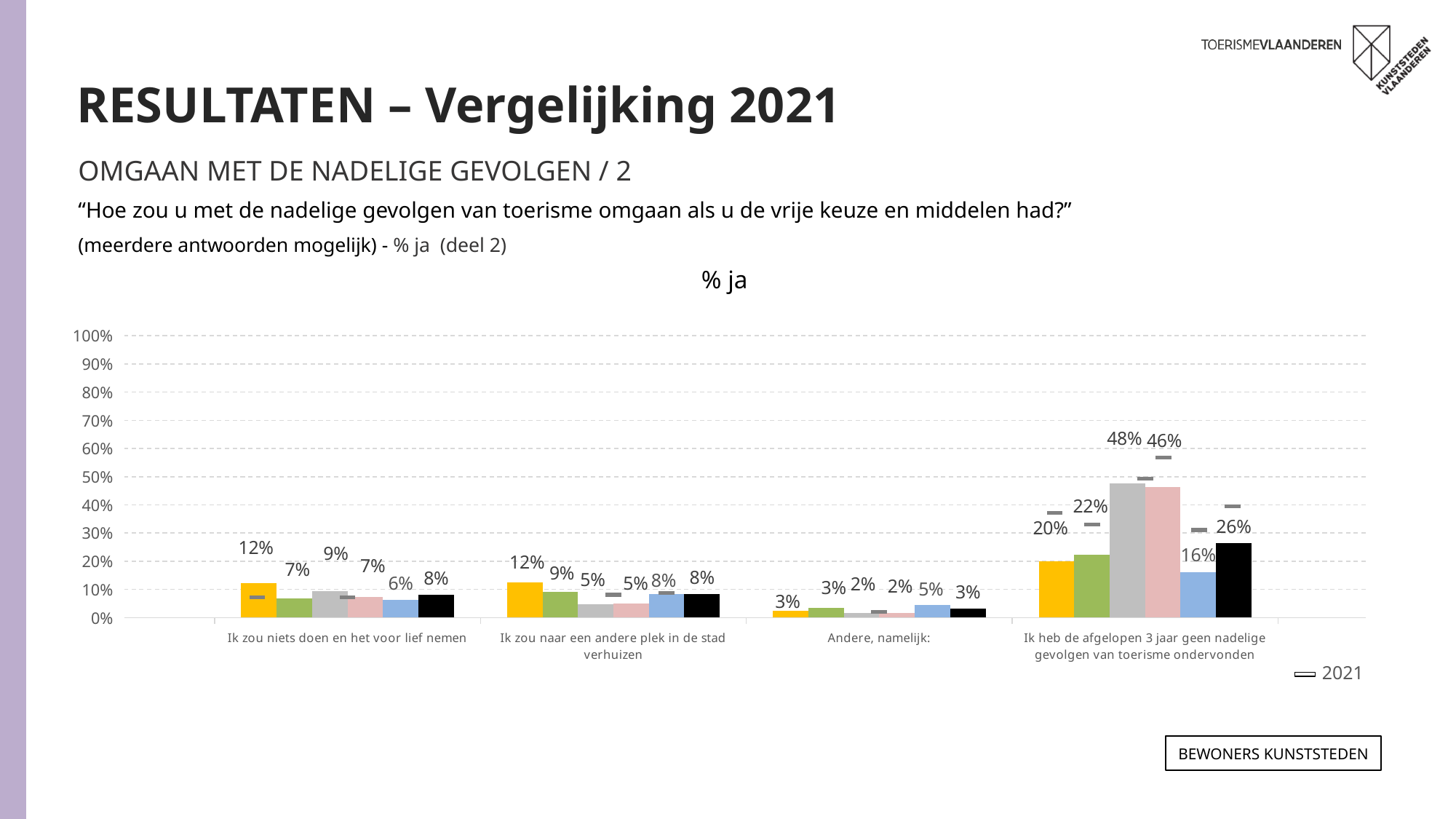
Is the value of the pink bar for 'Ik heb de afgelopen 3 jaar geen nadelige gevolgen van toerisme ondervonden' greater or less than 40%? greater What is the difference between the grey bar (48%) and the blue bar (16%) for 'Ik heb de afgelopen 3 jaar geen nadelige gevolgen van toerisme ondervonden'? 32% How many categories are shown on the x axis of the chart? 4 What is the value of the yellow bar for 'Ik zou niets doen en het voor lief nemen'? 12% What is the value of the blue bar for 'Andere, namelijk:'? 5% Which is larger for 'Ik zou naar een andere plek in de stad verhuizen': the yellow bar or the grey bar? the yellow bar What is the value of the black bar for 'Ik heb de afgelopen 3 jaar geen nadelige gevolgen van toerisme ondervonden'? 26% Which category has the highest bar in the chart? Ik heb de afgelopen 3 jaar geen nadelige gevolgen van toerisme ondervonden How many entries does the chart's legend list? 1 What is the title of the chart? % ja What is the value of the grey bar for 'Ik heb de afgelopen 3 jaar geen nadelige gevolgen van toerisme ondervonden'? 48% What kind of chart is shown on the slide? bar chart